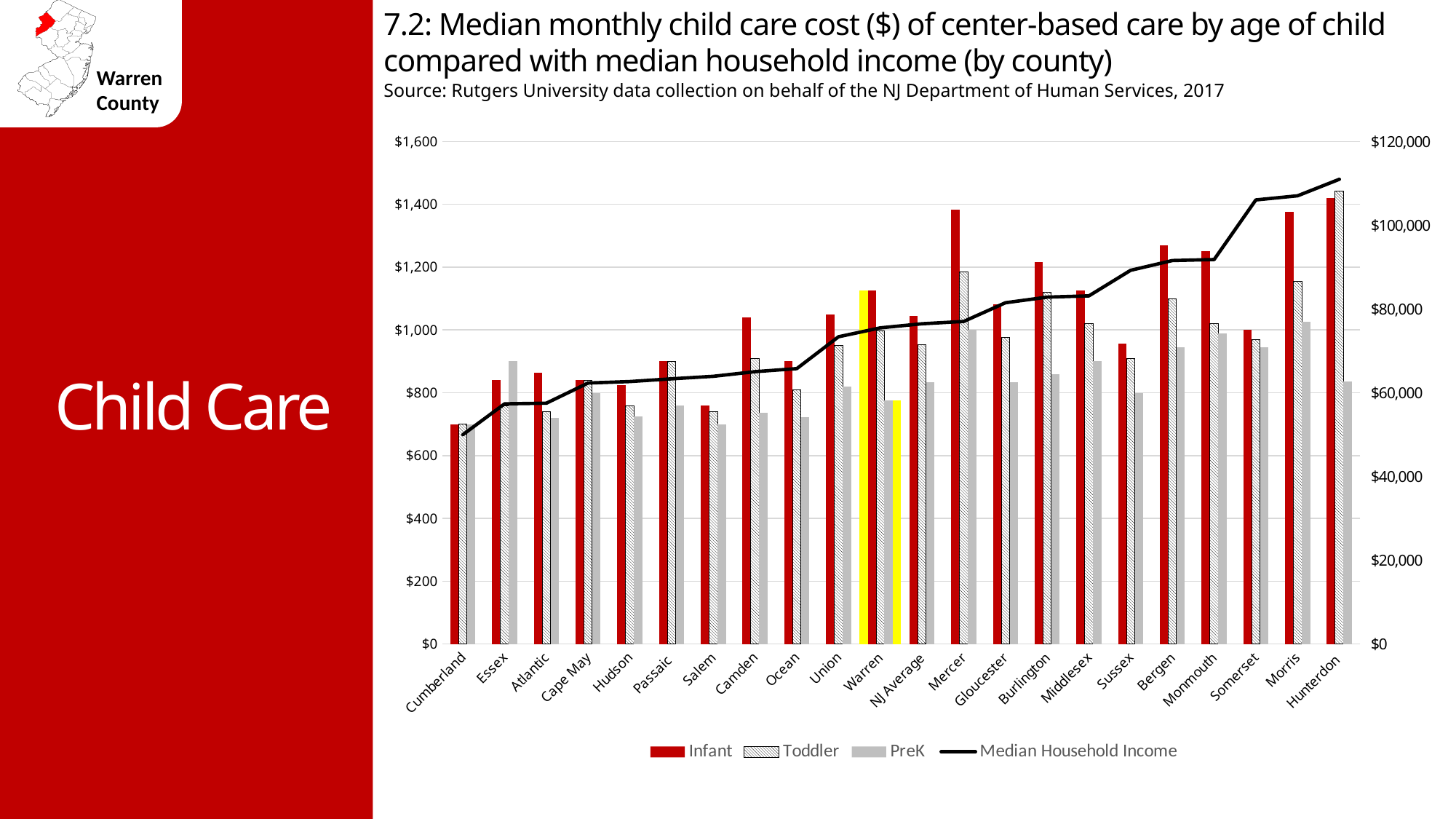
Which category has the highest Median Household Income? Hunterdon Is the PreK cost for Warren greater or less than $800? less Which category has the highest Toddler cost? Hunterdon What kind of chart is shown on the slide? Bar chart with a line Which category has the lowest Infant cost? Cumberland How many counties/categories are shown along the x axis? 22 Which is larger, the Infant cost for Warren or the Infant cost for NJ Average? Warren How many series does the legend list? 4 Does the Median Household Income line generally rise or fall from left to right across the counties? rise Which county's bars are highlighted in yellow? Warren Is the Infant cost for Warren greater or less than $1,000? greater Is the Median Household Income for Hunterdon greater or less than $100,000? greater